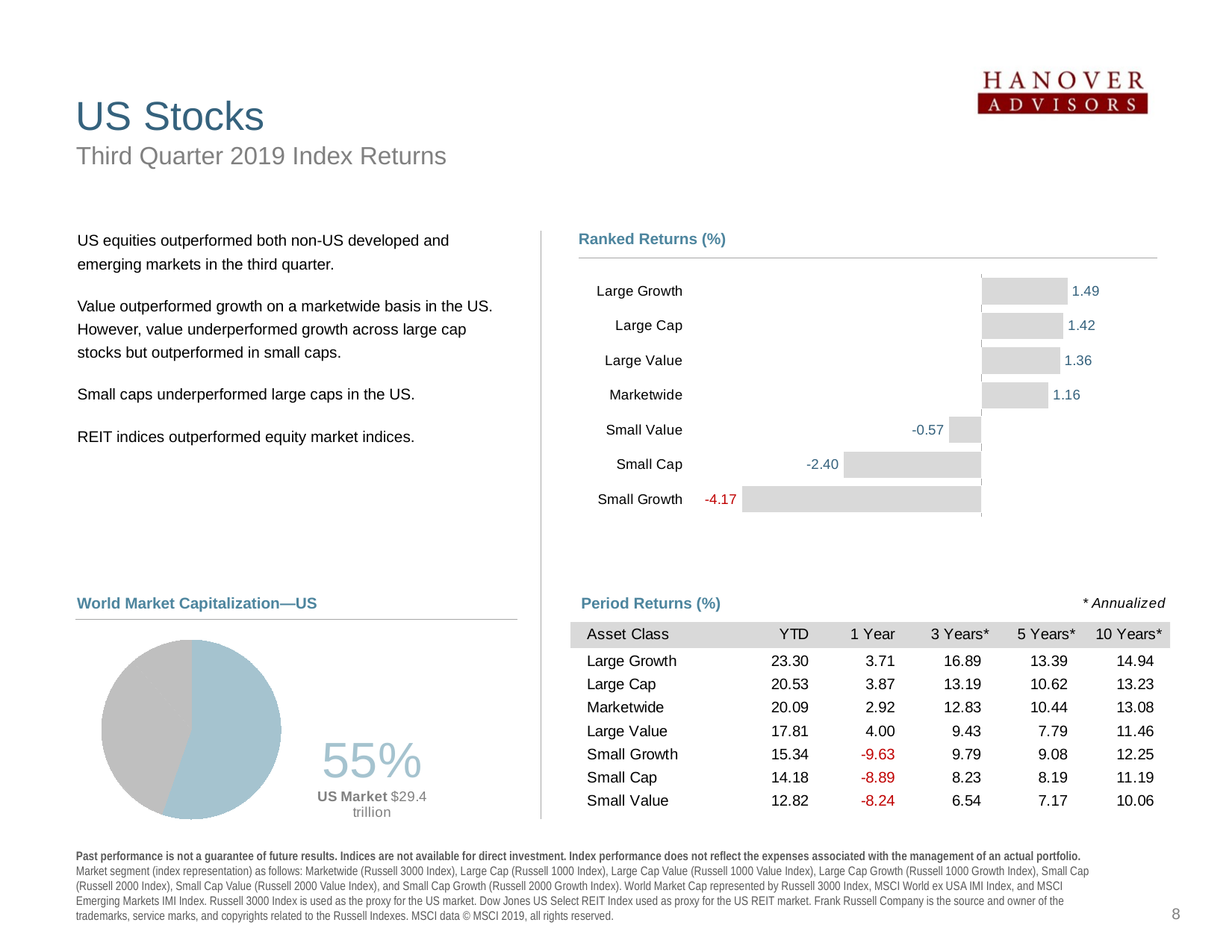
In the Ranked Returns (%) chart, which is larger, the value for Large Cap or the value for Small Value? Large Cap In the Ranked Returns (%) chart, what is the value for Marketwide? 1.16 In the Ranked Returns (%) chart, which category has the highest return? Large Growth What kind of chart is the World Market Capitalization—US chart? Pie chart In the Ranked Returns (%) chart, what is the difference between the Large Growth and Large Value values? 0.13 In the Ranked Returns (%) chart, which category has the lowest return? Small Growth How many categories are shown in the Ranked Returns (%) chart? 7 In the Ranked Returns (%) chart, what is the value for Large Growth? 1.49 What kind of chart is the Ranked Returns (%) chart? Bar chart In the Ranked Returns (%) chart, what is the value for Small Cap? -2.40 In the World Market Capitalization—US pie chart, what share does the US Market represent? 55% In the Ranked Returns (%) chart, what is the difference between the Small Value and Small Growth values? 3.60